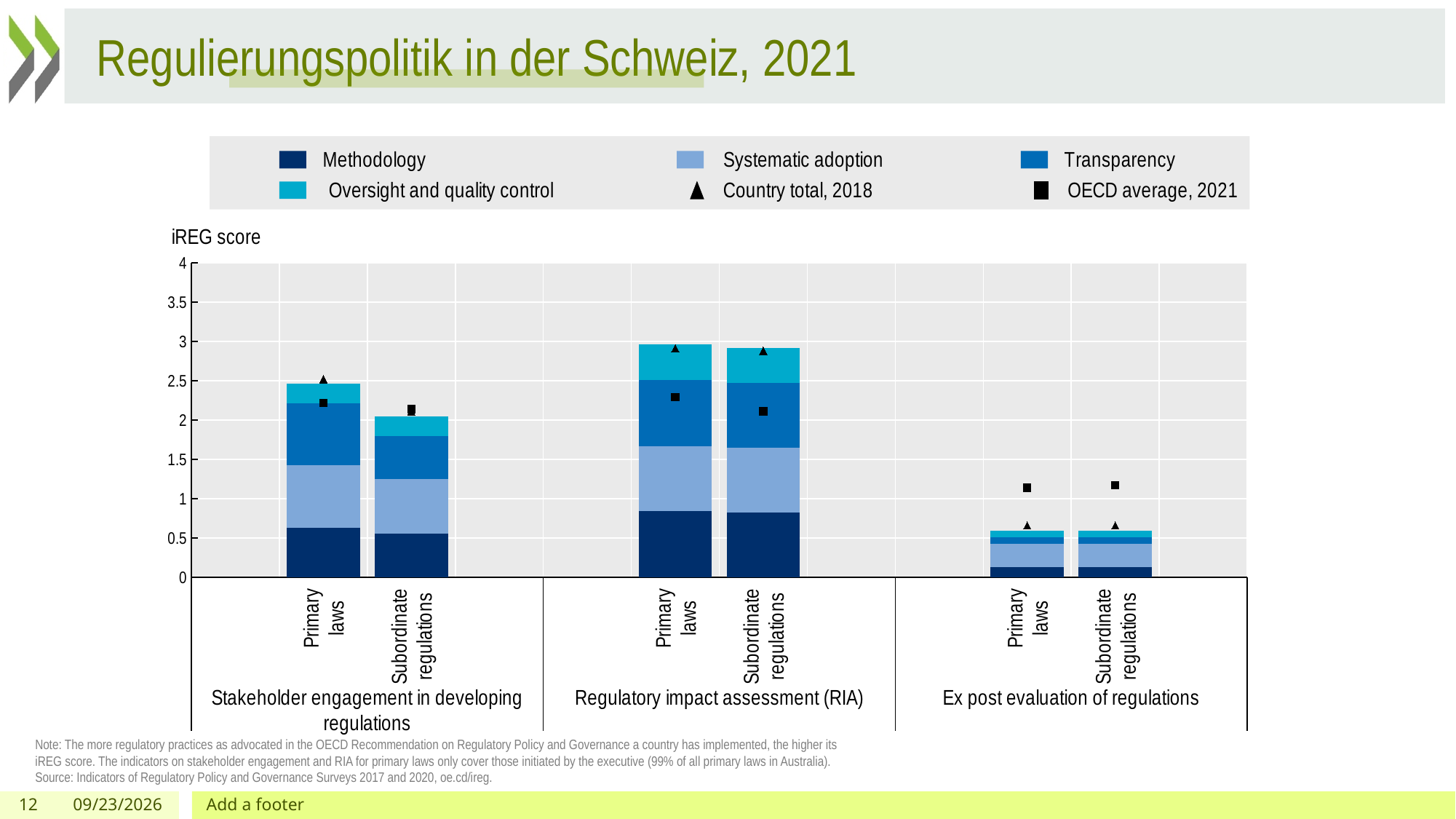
Which policy area has the shortest bars? Ex post evaluation of regulations Within Stakeholder engagement in developing regulations, which bar is taller: Primary laws or Subordinate regulations? Primary laws Is the total iREG score for Primary laws under Regulatory impact assessment (RIA) greater or less than 2.5? greater What kind of chart is shown on the slide? Stacked bar chart Is the total iREG score for Primary laws under Ex post evaluation of regulations greater or less than 1? less What label is shown on the vertical axis of the chart? iREG score Which is taller: the Primary laws bar for Regulatory impact assessment (RIA) or the Primary laws bar for Stakeholder engagement in developing regulations? Regulatory impact assessment (RIA) Which policy area has the tallest bars? Regulatory impact assessment (RIA) Is the total iREG score for Primary laws under Stakeholder engagement in developing regulations greater or less than 2? greater How many entries does the legend list? 6 How many bars are plotted in the chart? 6